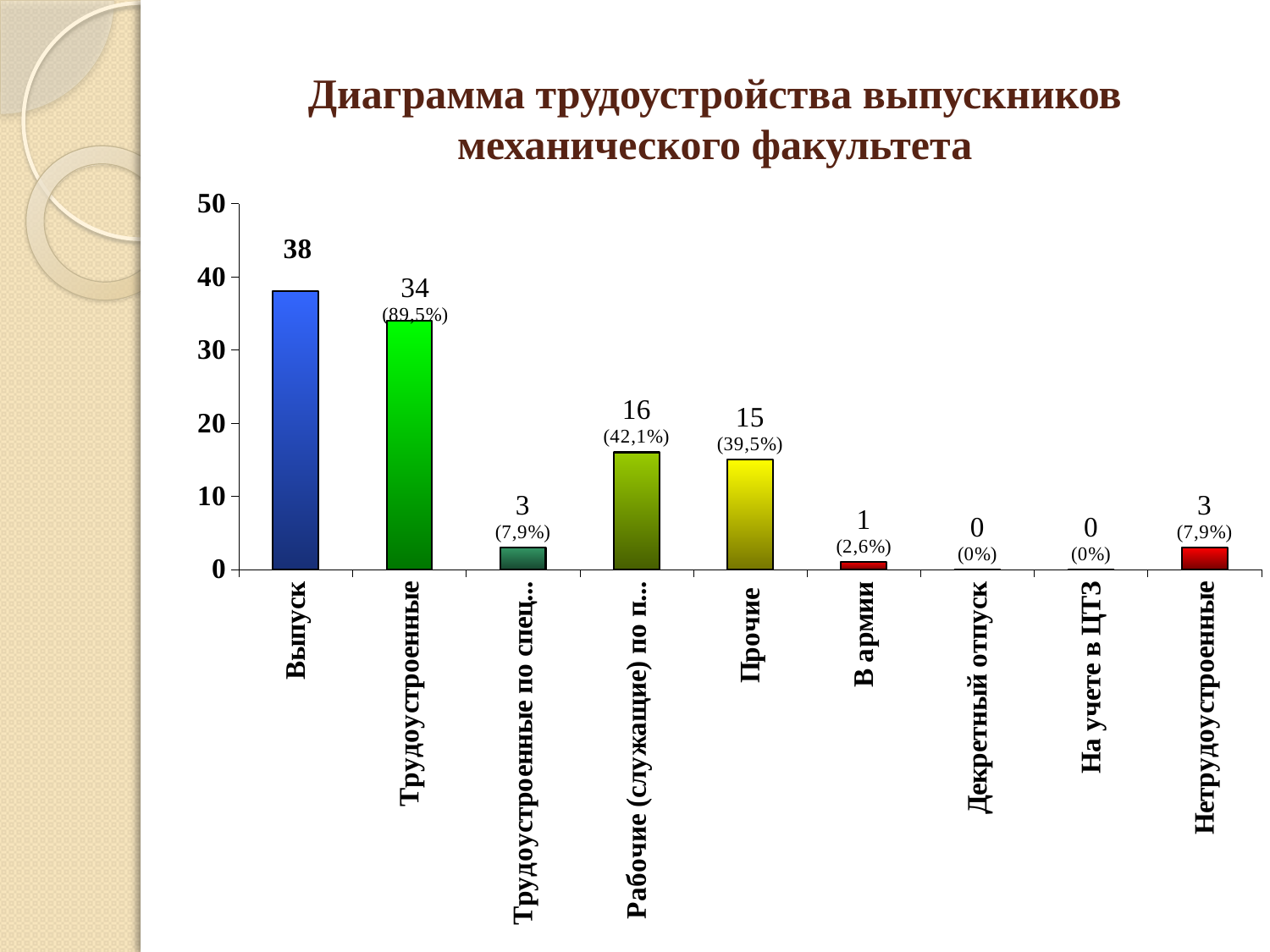
What percentage is shown for В армии? 2,6% What is the value for Выпуск? 38 How many categories are shown on the x axis? 9 Which category has the highest value? Выпуск What is the value for Прочие? 15 What type of chart is shown on the slide? bar chart What is the value for Нетрудоустроенные? 3 What is the title of the chart? Диаграмма трудоустройства выпускников механического факультета What is the value for Трудоустроенные? 34 Which is larger, the value for Прочие or the value for В армии? Прочие What is the difference between the values for Выпуск and Трудоустроенные? 4 What percentage is shown for Трудоустроенные? 89,5%